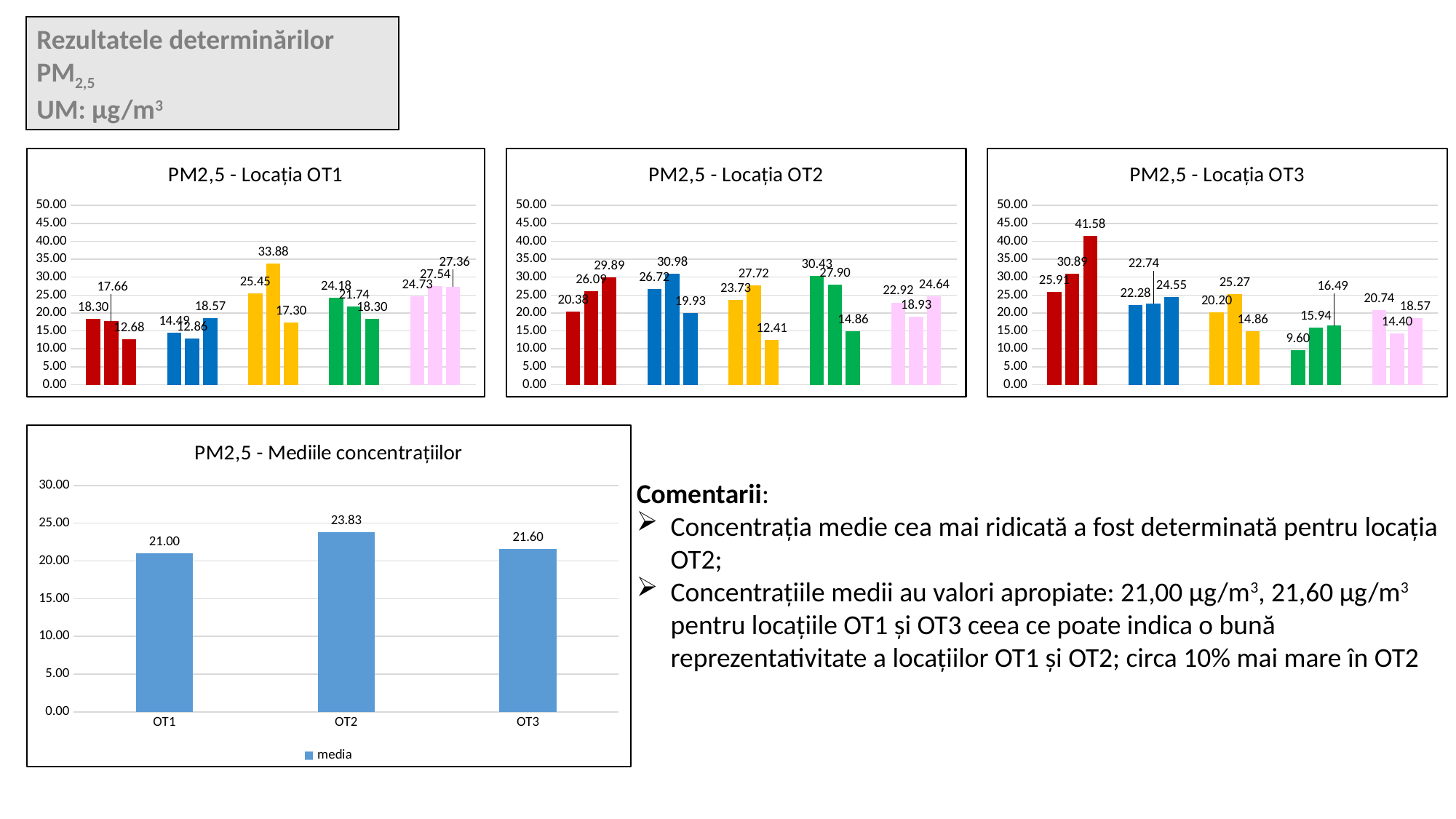
In the chart 'PM2,5 - Mediile concentrațiilor', what is the difference between the values for OT2 and OT3? 2.23 In the chart 'PM2,5 - Mediile concentrațiilor', which is larger, the value for OT3 or the value for OT1? OT3 In the chart 'PM2,5 - Mediile concentrațiilor', what is the value for OT2? 23.83 In the chart 'PM2,5 - Mediile concentrațiilor', what is the value for OT1? 21.00 What kind of chart is 'PM2,5 - Mediile concentrațiilor'? bar chart In the chart 'PM2,5 - Mediile concentrațiilor', which location has the highest value? OT2 In the chart 'PM2,5 - Locația OT3', what is the highest value shown? 41.58 How many series does the legend of the chart 'PM2,5 - Mediile concentrațiilor' list? 1 In the chart 'PM2,5 - Locația OT2', what is the lowest value shown? 12.41 How many locations are shown in the chart 'PM2,5 - Mediile concentrațiilor'? 3 In the chart 'PM2,5 - Mediile concentrațiilor', which location has the lowest value? OT1 What is the legend entry in the chart 'PM2,5 - Mediile concentrațiilor'? media